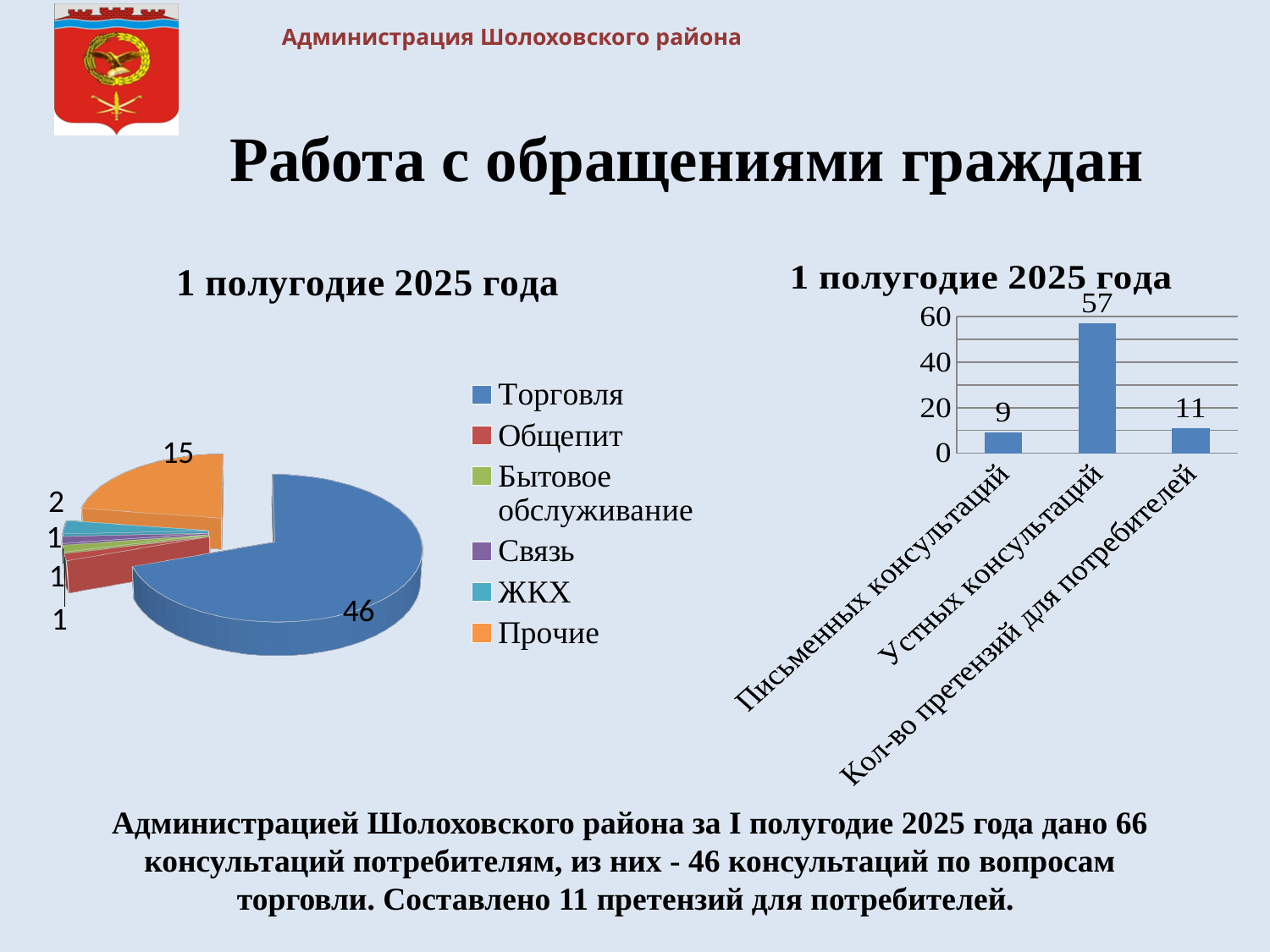
In the pie chart on the left, which category has the largest slice? Торговля In the bar chart on the right, what is the value for Письменных консультаций? 9 In the bar chart on the right, what is the difference between Устных консультаций and Письменных консультаций? 48 In the pie chart on the left, what is the value for Торговля? 46 In the pie chart on the left, what is the value for Прочие? 15 In the bar chart on the right, which category has the lowest value? Письменных консультаций In the bar chart on the right, what is the value for Кол-во претензий для потребителей? 11 In the bar chart on the right, how many categories are shown? 3 In the bar chart on the right, which category has the highest value? Устных консультаций In the bar chart on the right, what is the value for Устных консультаций? 57 How many entries does the legend of the pie chart on the left list? 6 What kind of chart is on the right side of the slide? bar chart